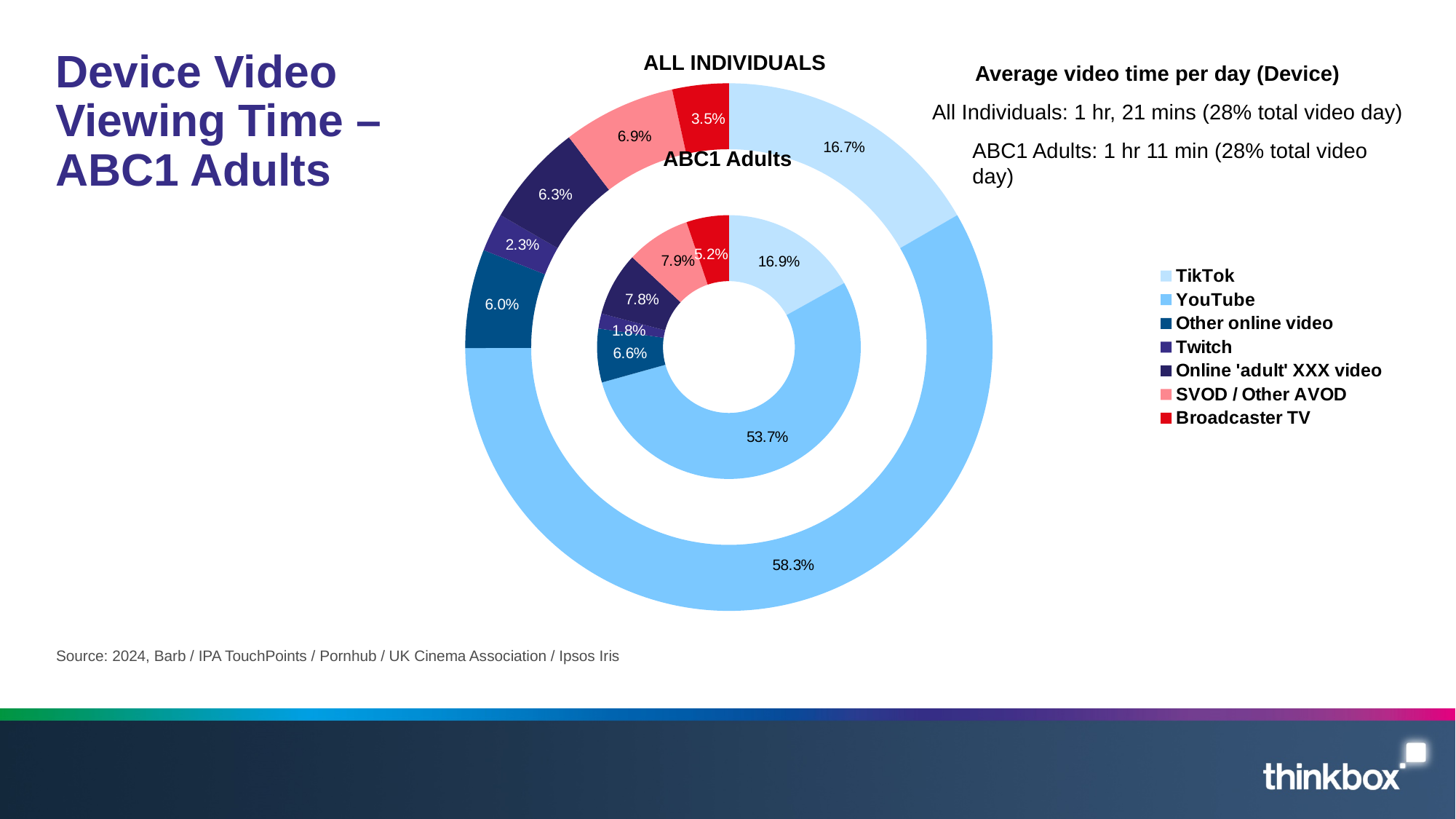
Which category has the largest share in the All Individuals ring? YouTube What type of chart is shown on the slide? Doughnut chart What is the TikTok share for ABC1 Adults (inner ring)? 16.9% What is the difference between the YouTube share for All Individuals (58.3%) and for ABC1 Adults (53.7%)? 4.6% What is the Twitch share for ABC1 Adults (inner ring)? 1.8% What is the YouTube share for All Individuals (outer ring)? 58.3% How many categories does the legend list? 7 What is the YouTube share for ABC1 Adults (inner ring)? 53.7% What is the Broadcaster TV share for All Individuals (outer ring)? 3.5% Which is larger: the Broadcaster TV share for ABC1 Adults or for All Individuals? ABC1 Adults Which ring of the doughnut chart represents ABC1 Adults, the inner or the outer? Inner Which category has the smallest share in the ABC1 Adults ring? Twitch